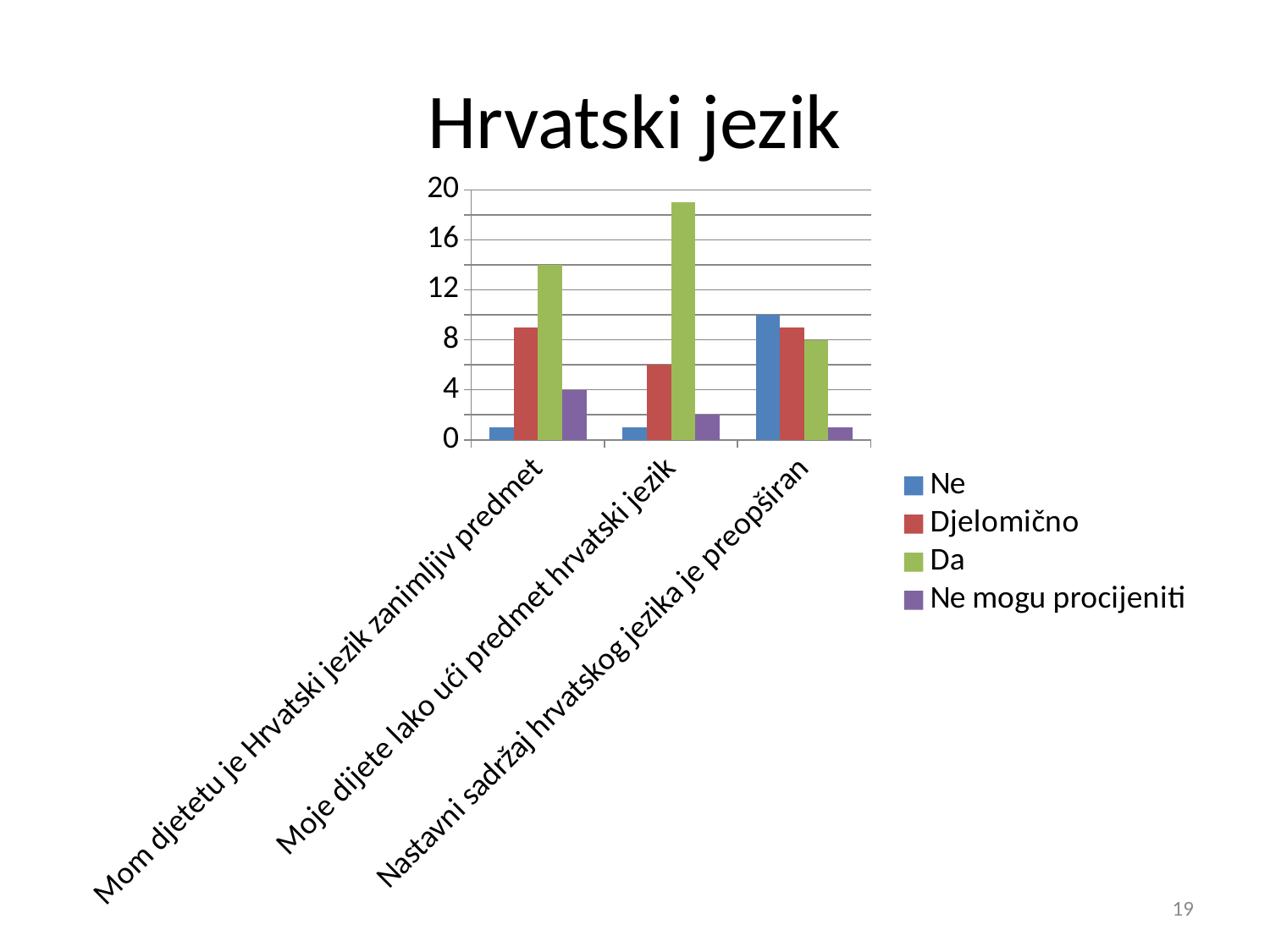
Is the value of "Da" for "Moje dijete lako uči predmet hrvatski jezik" greater or less than 16? greater What is the title of the chart? Hrvatski jezik What kind of chart is shown on the slide? bar chart How many series does the legend list? 4 Which series has the highest value for "Moje dijete lako uči predmet hrvatski jezik"? Da What is the value of "Da" for "Nastavni sadržaj hrvatskog jezika je preopširan"? 8 Is the value of "Ne" for "Nastavni sadržaj hrvatskog jezika je preopširan" greater or less than 8? greater For "Nastavni sadržaj hrvatskog jezika je preopširan", which is larger: "Ne" or "Da"? Ne Which series has the lowest value for "Mom djetetu je Hrvatski jezik zanimljiv predmet"? Ne For which category is the "Da" value the highest? Moje dijete lako uči predmet hrvatski jezik What is the value of "Ne mogu procijeniti" for "Mom djetetu je Hrvatski jezik zanimljiv predmet"? 4 How many categories are shown on the x axis? 3